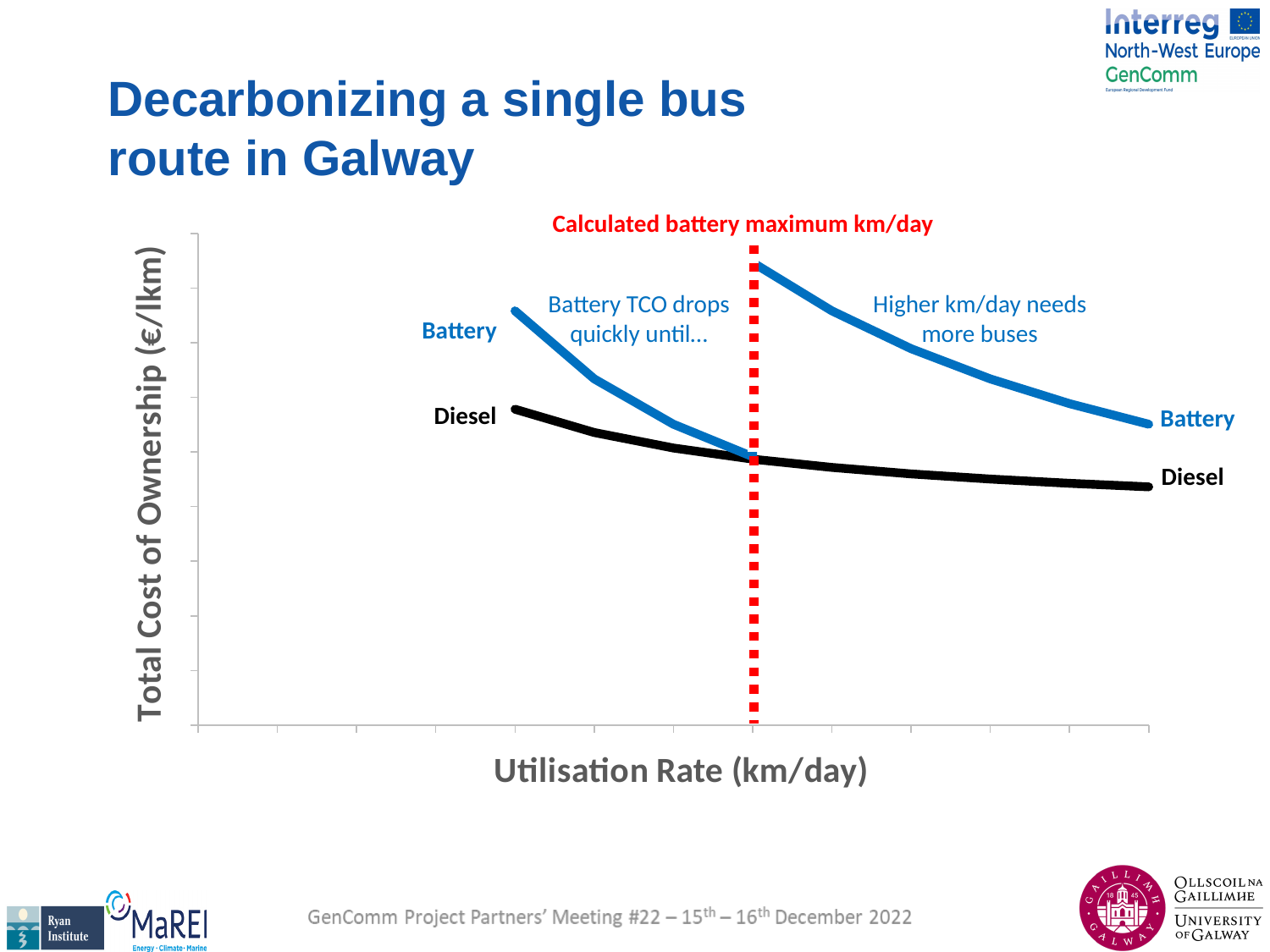
What is the label of the y axis? Total Cost of Ownership (€/lkm) Does the Diesel line rise or fall as the utilisation rate increases? Fall What is the label of the x axis? Utilisation Rate (km/day) How many series are plotted on the chart? 2 At the right end of the chart, which series has the lower total cost of ownership, Battery or Diesel? Diesel What kind of chart is shown on the slide? Line chart What are the names of the two series plotted on the chart? Battery and Diesel Does the Battery line rise or fall as the utilisation rate increases up to the dashed red line? Fall At the left end of the chart, which series has the higher total cost of ownership, Battery or Diesel? Battery